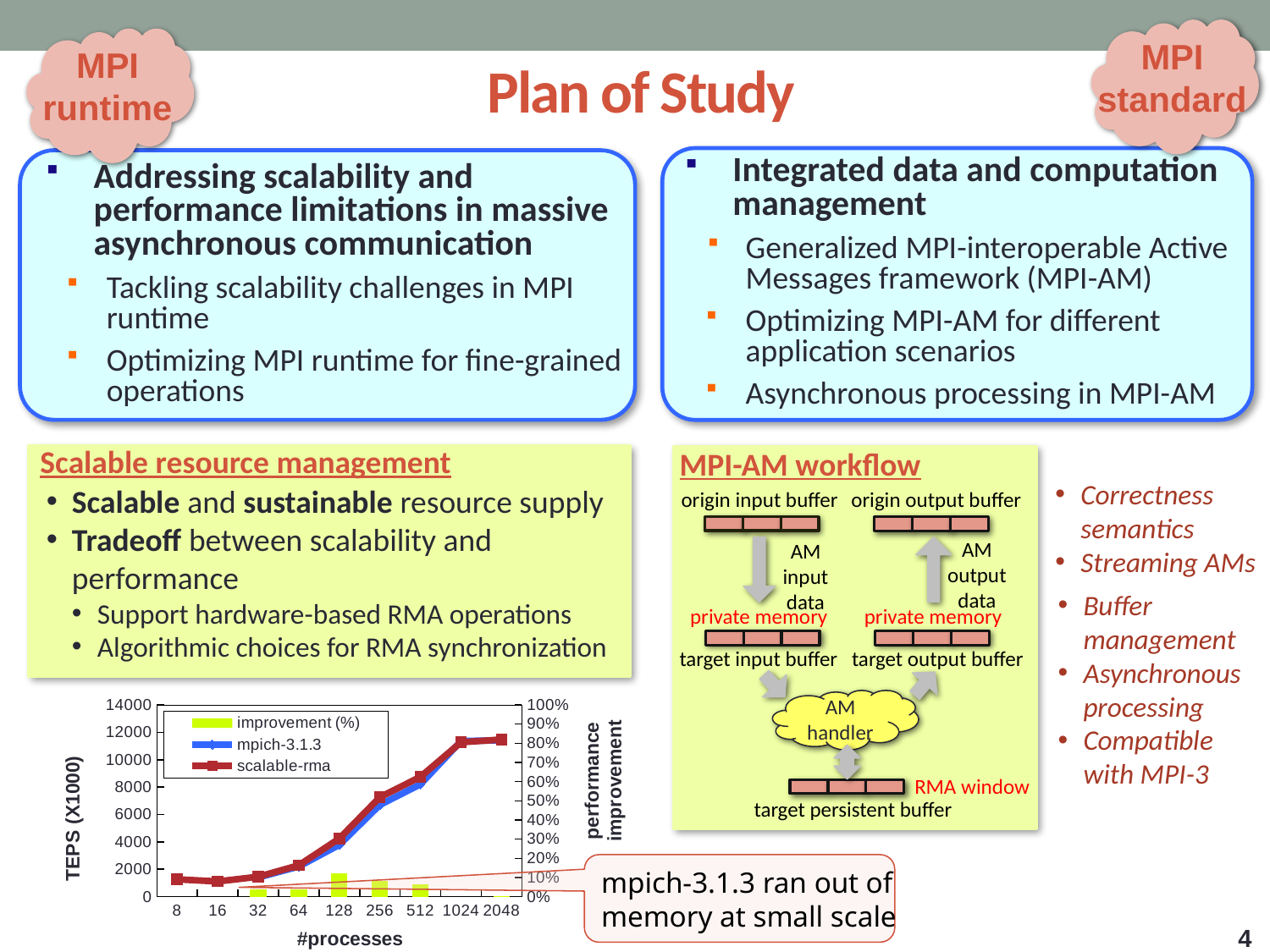
What is the title of the x axis of the chart? #processes What is the title of the left y axis of the chart? TEPS (X1000) Is the scalable-rma value at 1024 processes greater or less than 10000? greater Is the improvement (%) value at 32 processes greater or less than 10%? less Is the scalable-rma value at 8 processes greater or less than 2000? less How many series does the legend of the chart list? 3 Does the scalable-rma series rise or fall as the number of processes increases? Rises What kind of chart is shown at the bottom left of the slide? A combined line and bar chart Which is larger for scalable-rma: the value at 2048 processes or the value at 8 processes? 2048 processes How many process counts are shown on the x axis of the chart? 9